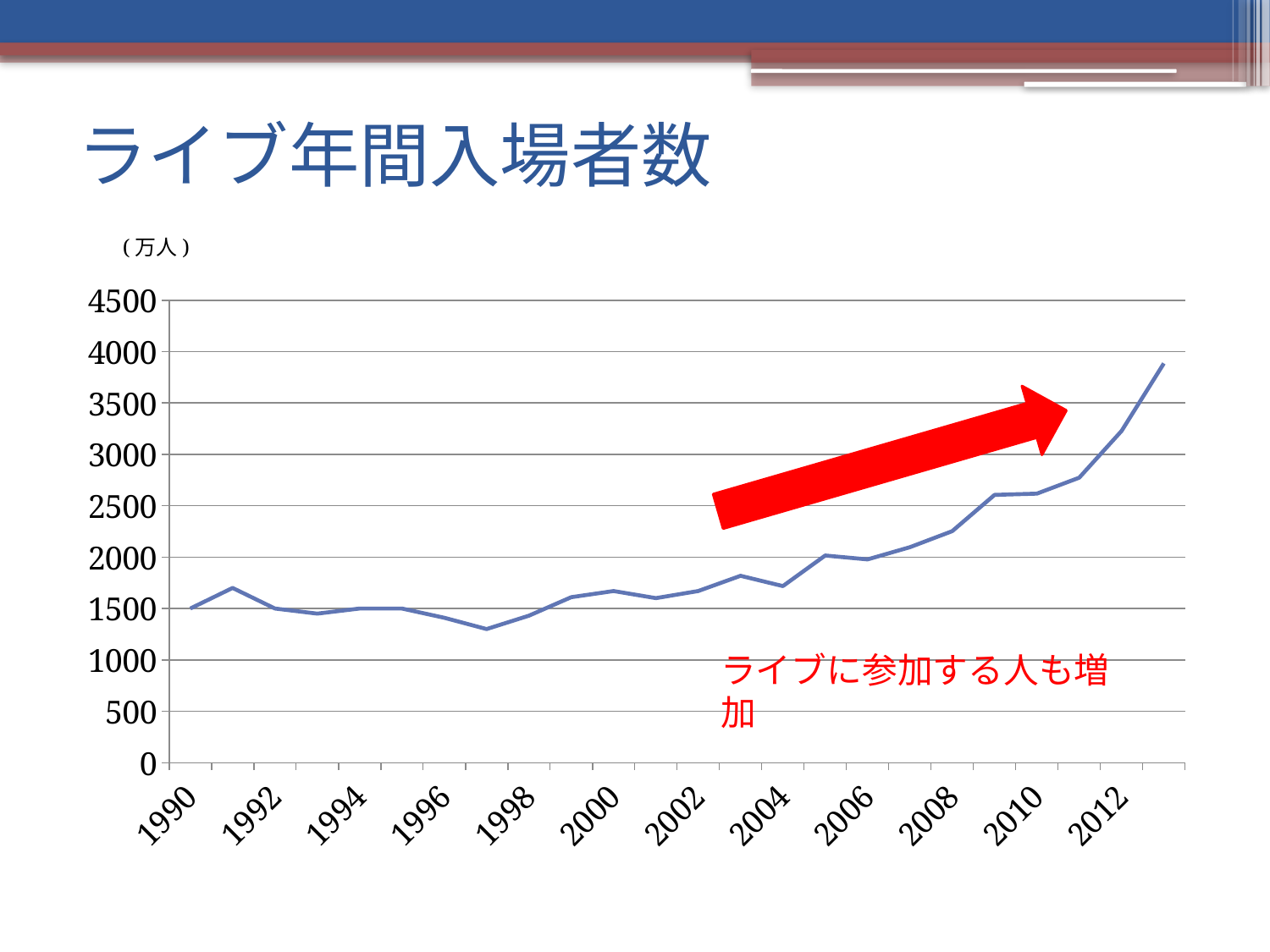
Overall, do the values rise or fall from 1990 to the end of the series? rise Is the value for 2004 greater or less than 2000? less Is the value for 1998 greater or less than 1500? less Among the years labeled on the x axis, which has the highest value? 2012 What unit is shown above the y axis of the chart? 万人 How many lines are plotted on the chart? 1 Is the value for 2008 greater or less than 2000? greater What kind of chart is shown on the slide? line chart Which is larger, the value for 2006 or the value for 2000? 2006 What is the title of the chart? ライブ年間入場者数